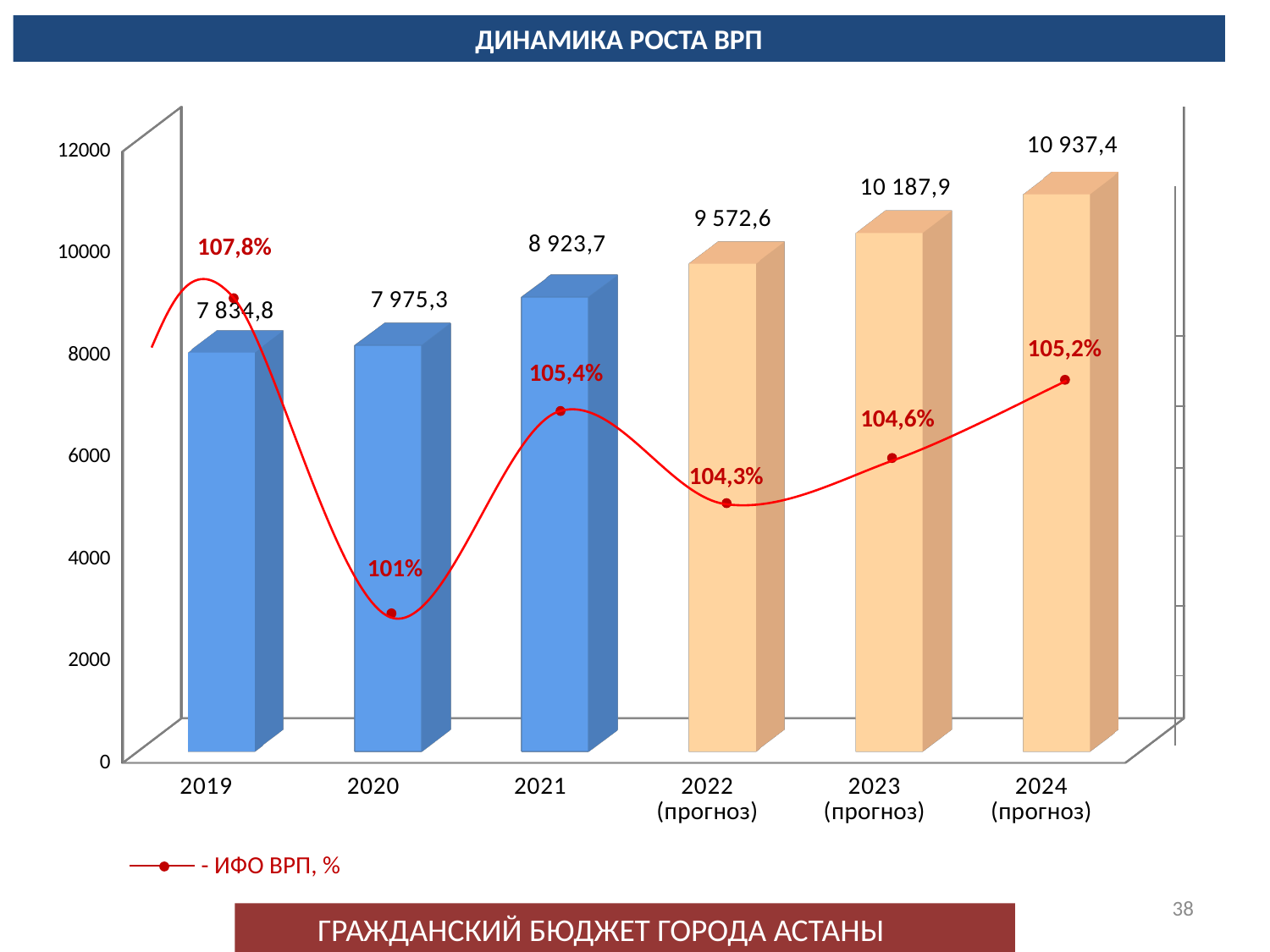
What is the ВРП value shown for 2024 (прогноз)? 10 937,4 Which year has the highest ВРП bar? 2024 (прогноз) What is the difference between the ВРП values for 2021 and 2020? 948,4 Do the ВРП bar values rise or fall from 2019 to 2024? rise Which is larger, the ВРП value for 2022 (прогноз) or for 2023 (прогноз)? 2023 (прогноз) How many series does the legend list? 1 Which year has the lowest ИФО ВРП, % value? 2020 Is the ВРП value for 2019 greater or less than 8000? less What kind of chart is used to show the ВРП values? bar chart What is the ИФО ВРП, % value shown for 2020? 101% What is the ВРП value shown for 2021? 8 923,7 How many years are shown on the x axis? 6